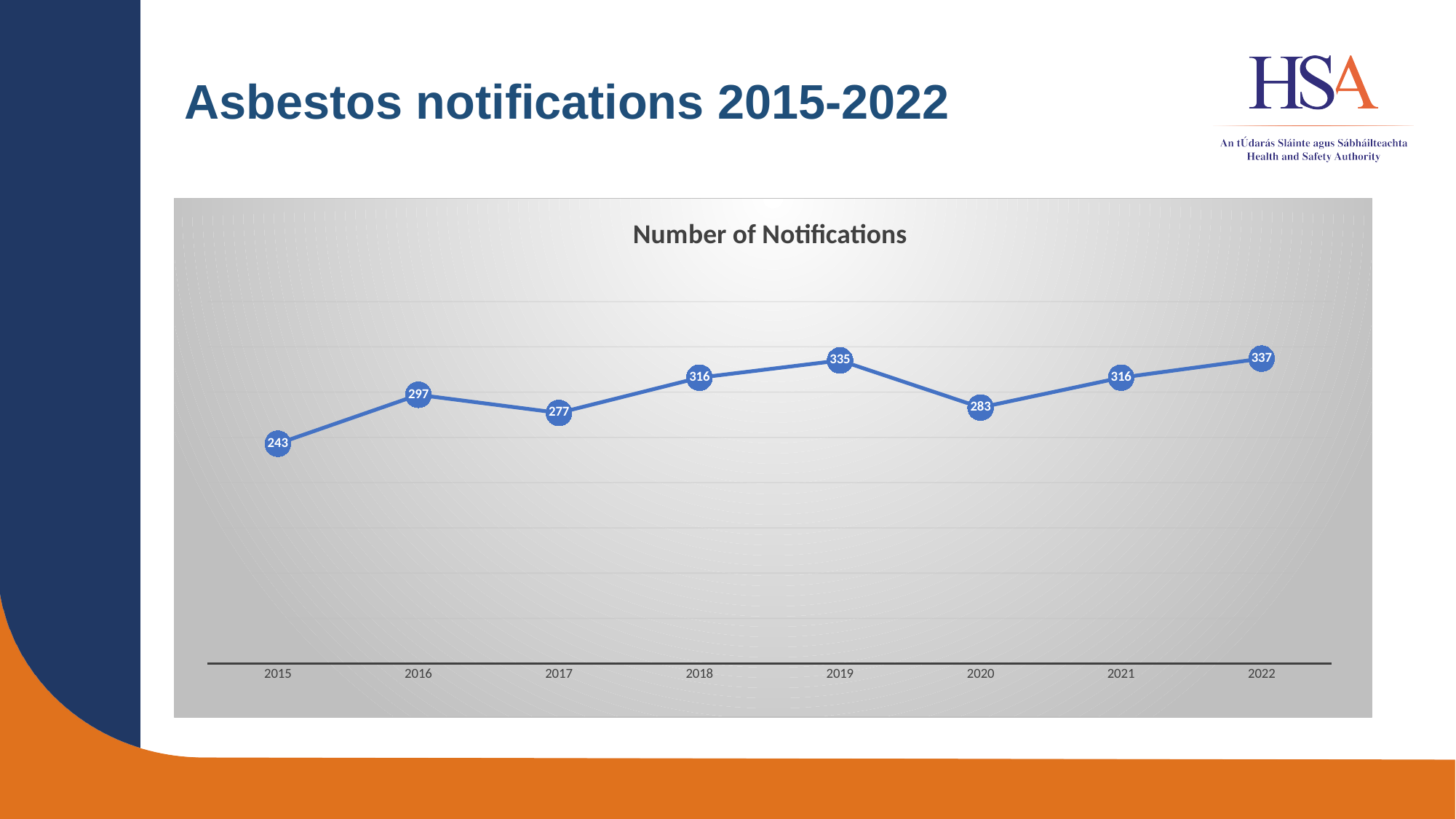
What is the number of notifications for 2022? 337 What is the number of notifications for 2020? 283 How many years are plotted on the chart? 8 What is the title of the chart? Number of Notifications What is the number of notifications for 2019? 335 What is the number of notifications for 2015? 243 What is the difference between the number of notifications in 2019 and in 2020? 52 Which year has the highest number of notifications? 2022 What is the difference between the number of notifications in 2022 and in 2015? 94 What kind of chart is shown on the slide? Line chart Which year has the lowest number of notifications? 2015 Which year has more notifications, 2016 or 2017? 2016